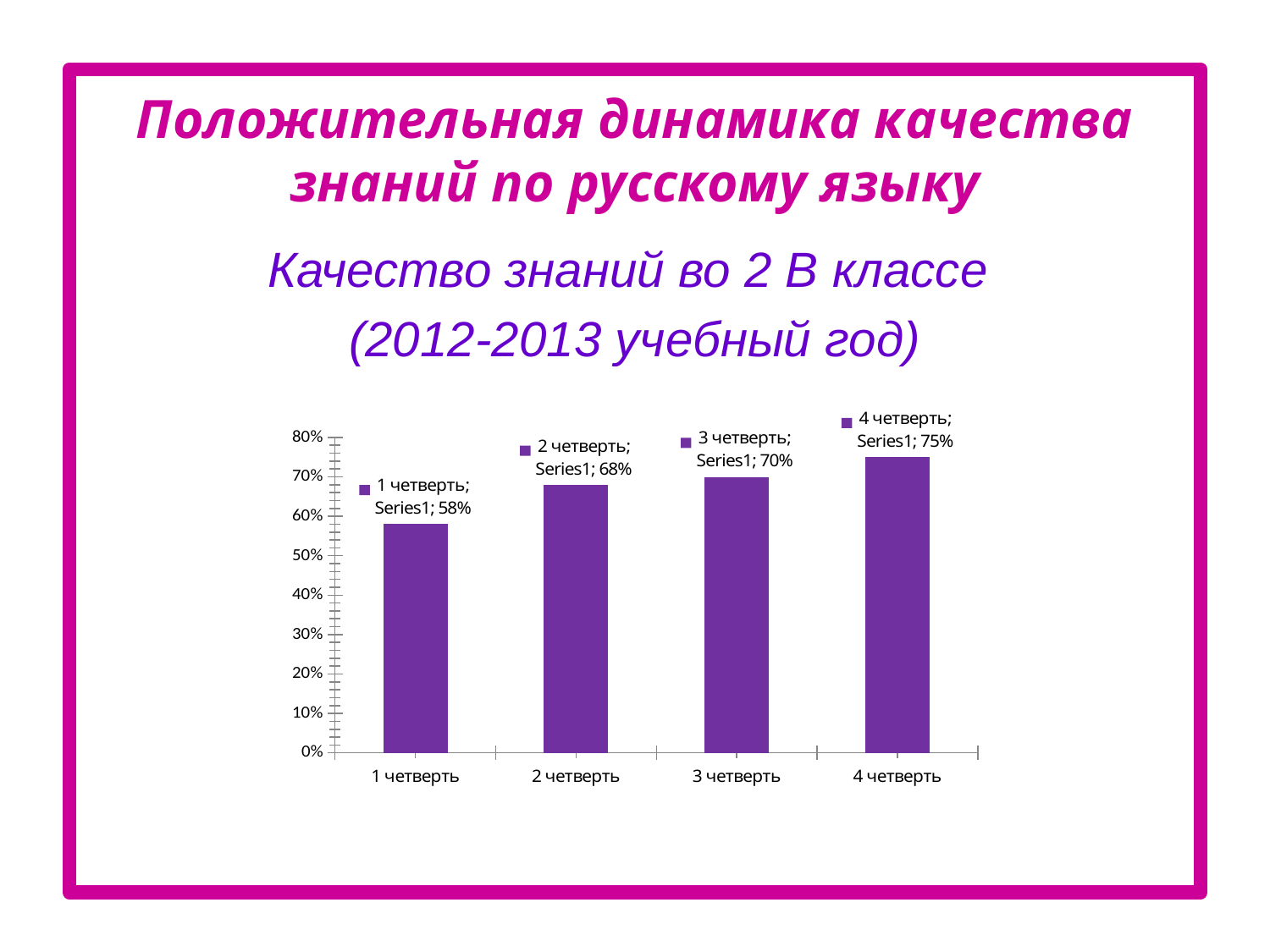
What is the difference between the values for 4 четверть and 1 четверть? 17% What is the value for 3 четверть? 70% Which is larger, the value for 2 четверть or 3 четверть? 3 четверть Which quarter has the highest value? 4 четверть Which quarter has the lowest value? 1 четверть Is the value for 1 четверть greater or less than 60%? less What kind of chart is shown on the slide? bar chart Do the values rise or fall from 1 четверть to 4 четверть? rise How many categories are shown on the x axis? 4 What is the value for 4 четверть? 75% What is the value for 1 четверть? 58% What is the value for 2 четверть? 68%